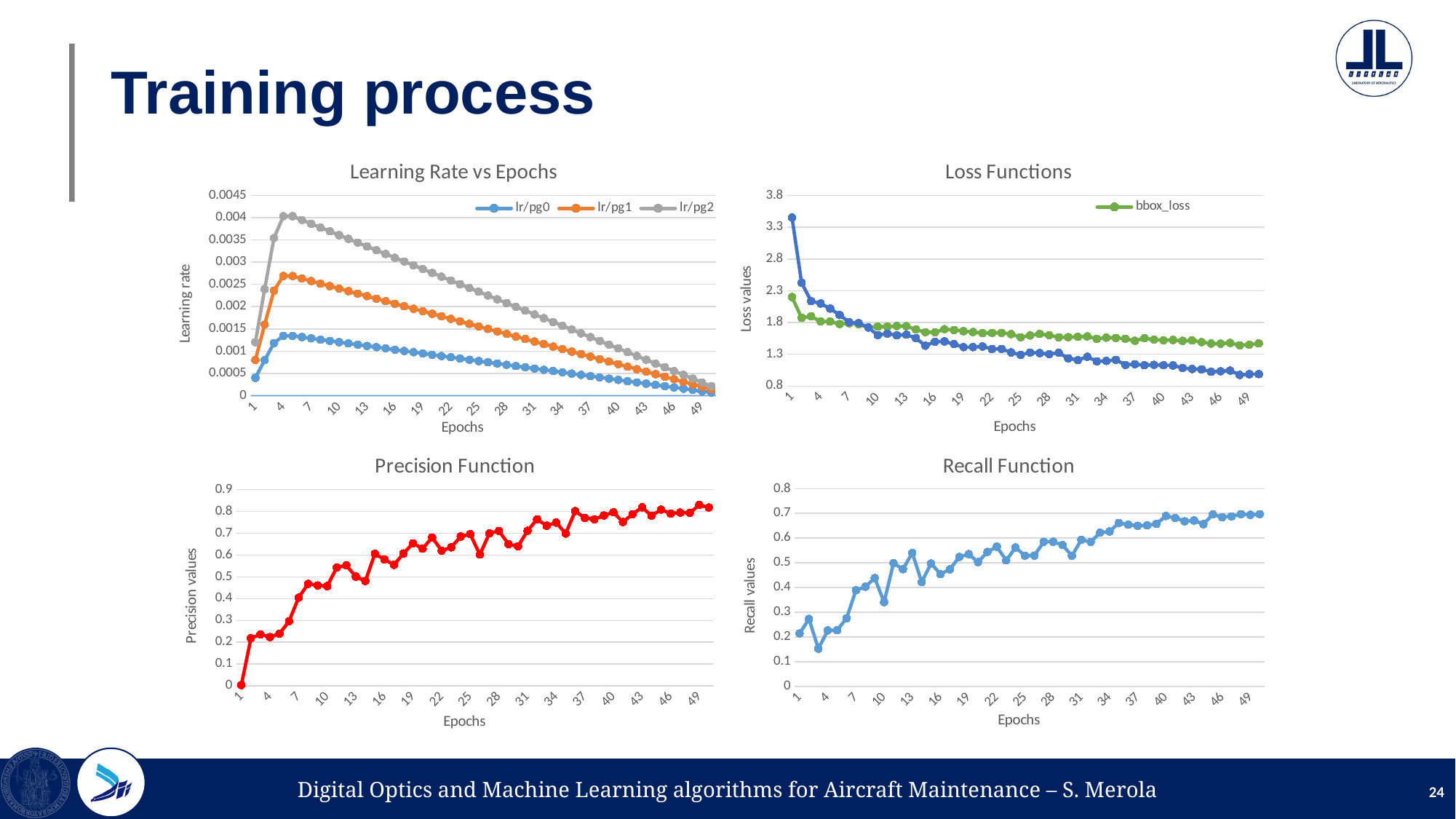
In the "Loss Functions" chart, do the loss values rise or fall as epochs increase? fall In the "Loss Functions" chart, is the value of the blue series at epoch 1 greater or less than 3.3? greater In the "Precision Function" chart, do the precision values rise or fall overall as epochs increase? rise In the "Learning Rate vs Epochs" chart, which series has the lowest learning rate values? lr/pg0 What kind of chart is the "Learning Rate vs Epochs" chart? line chart In the "Learning Rate vs Epochs" chart, after epoch 4, do the learning rate values rise or fall as epochs increase? fall In the "Learning Rate vs Epochs" chart, which series has the highest learning rate values? lr/pg2 What series name is listed in the legend of the "Loss Functions" chart? bbox_loss In the "Recall Function" chart, is the recall value at epoch 49 greater or less than 0.8? less How many series does the legend of the "Learning Rate vs Epochs" chart list? 3 In the "Learning Rate vs Epochs" chart, is the peak value of lr/pg1 greater or less than 0.003? less